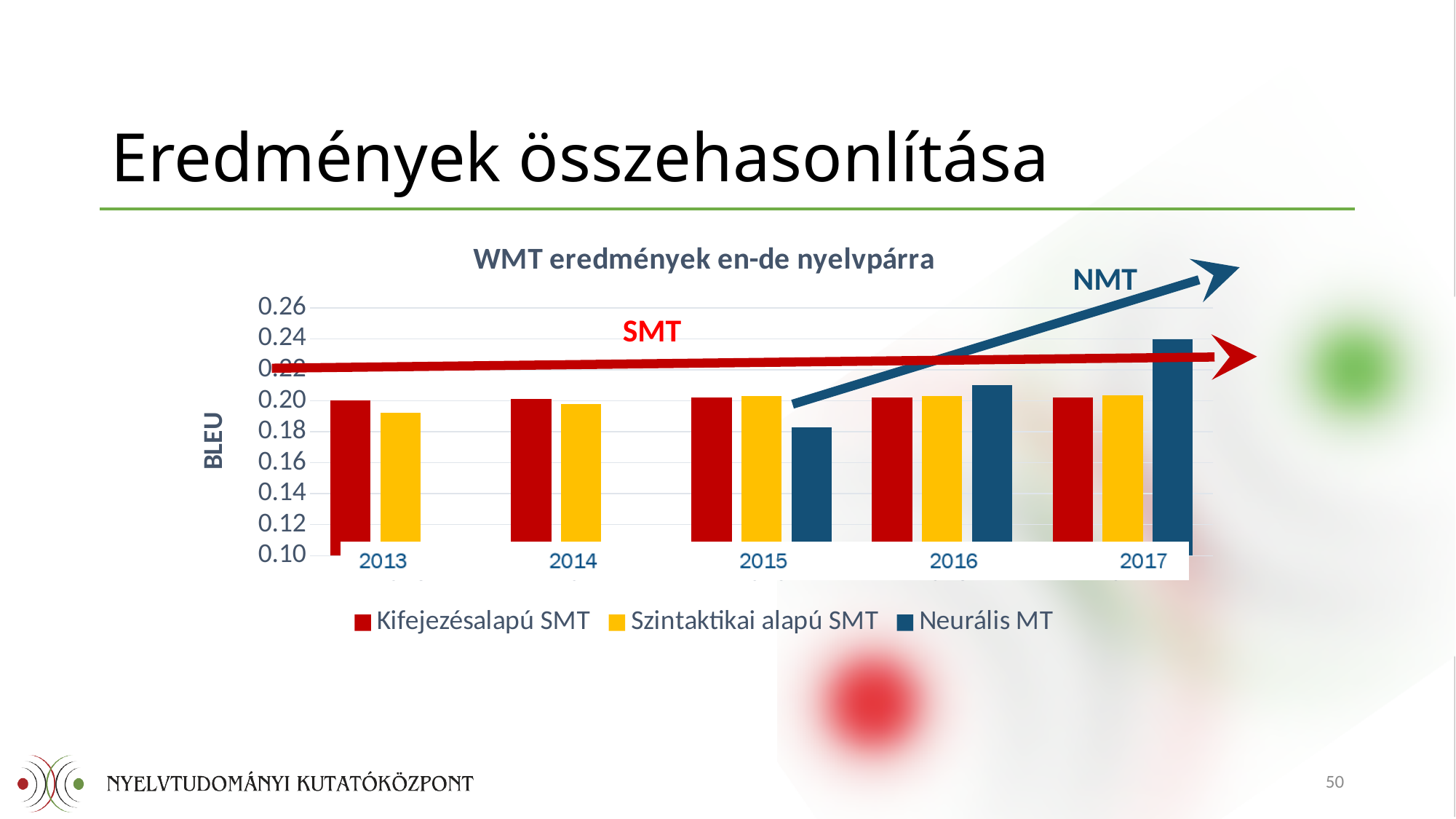
Is the Szintaktikai alapú SMT value for 2013 greater or less than 0.20? less In which year is the Neurális MT value lowest? 2015 Is the Neurális MT value for 2017 greater or less than 0.22? greater How many series does the legend list? 3 In 2017, which is larger: Neurális MT or Kifejezésalapú SMT? Neurális MT Does the Neurális MT value rise or fall from 2015 to 2017? rise What is the title of the chart? WMT eredmények en-de nyelvpárra How many years are shown on the x axis? 5 What type of chart is shown on the slide? bar chart In which year is the Neurális MT value highest? 2017 What is the label of the vertical axis? BLEU Is the Neurális MT value for 2015 greater or less than 0.20? less